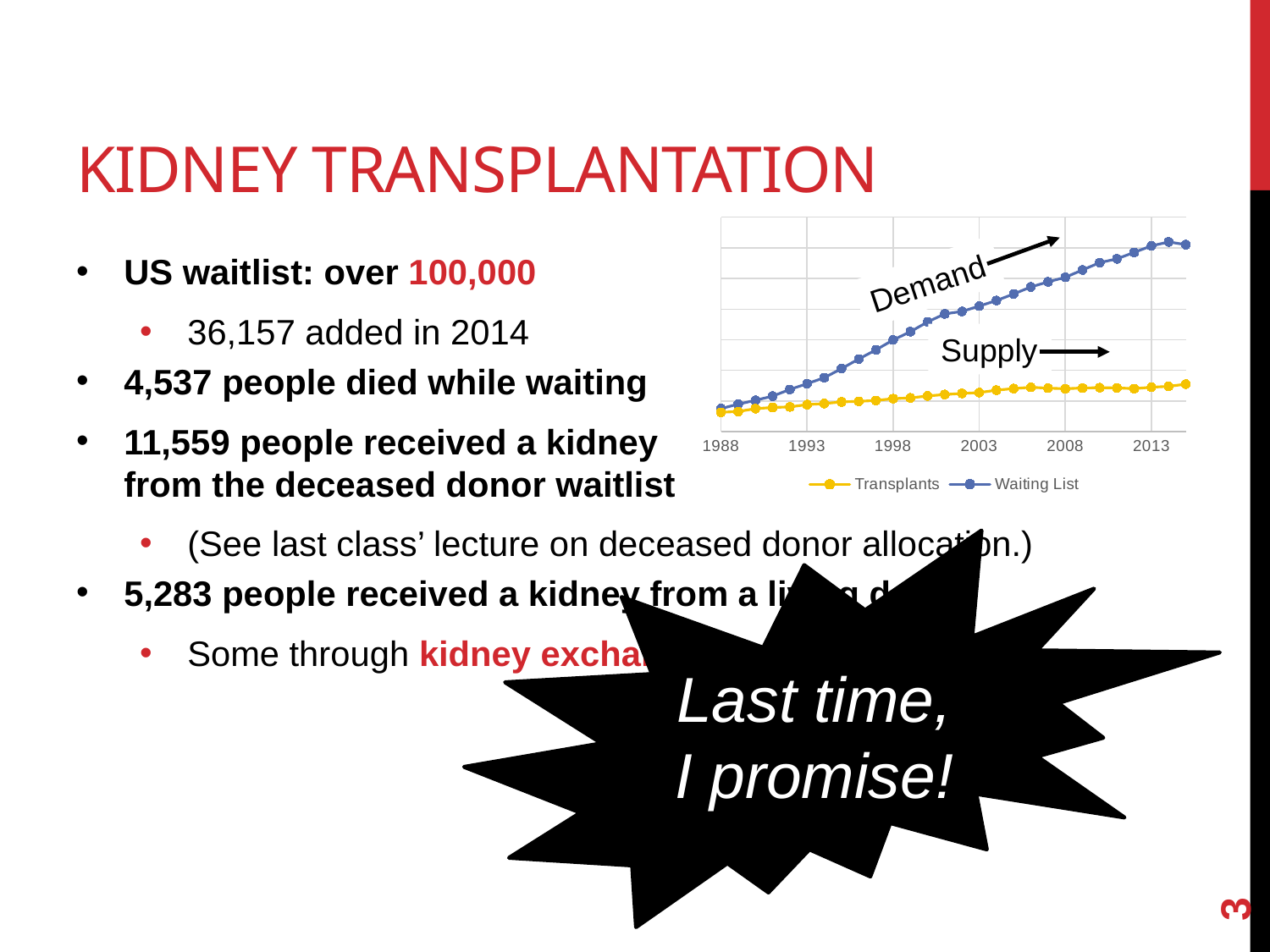
Does the Transplants series rise or fall over the years shown? rise Does the Waiting List series rise or fall from 1988 to 2013? rise Which series is higher at the right end of the chart? Waiting List What are the two series named in the chart's legend? Transplants and Waiting List What is the last year labeled on the chart's x axis? 2013 What is the first year labeled on the chart's x axis? 1988 How many series does the chart's legend list? 2 Which series grows faster over the period shown, Transplants or Waiting List? Waiting List What kind of chart is shown on the slide? line chart Which series is annotated as "Demand" on the chart? Waiting List In 2013, which series has the higher value, Transplants or Waiting List? Waiting List Which series stays lowest across the chart? Transplants